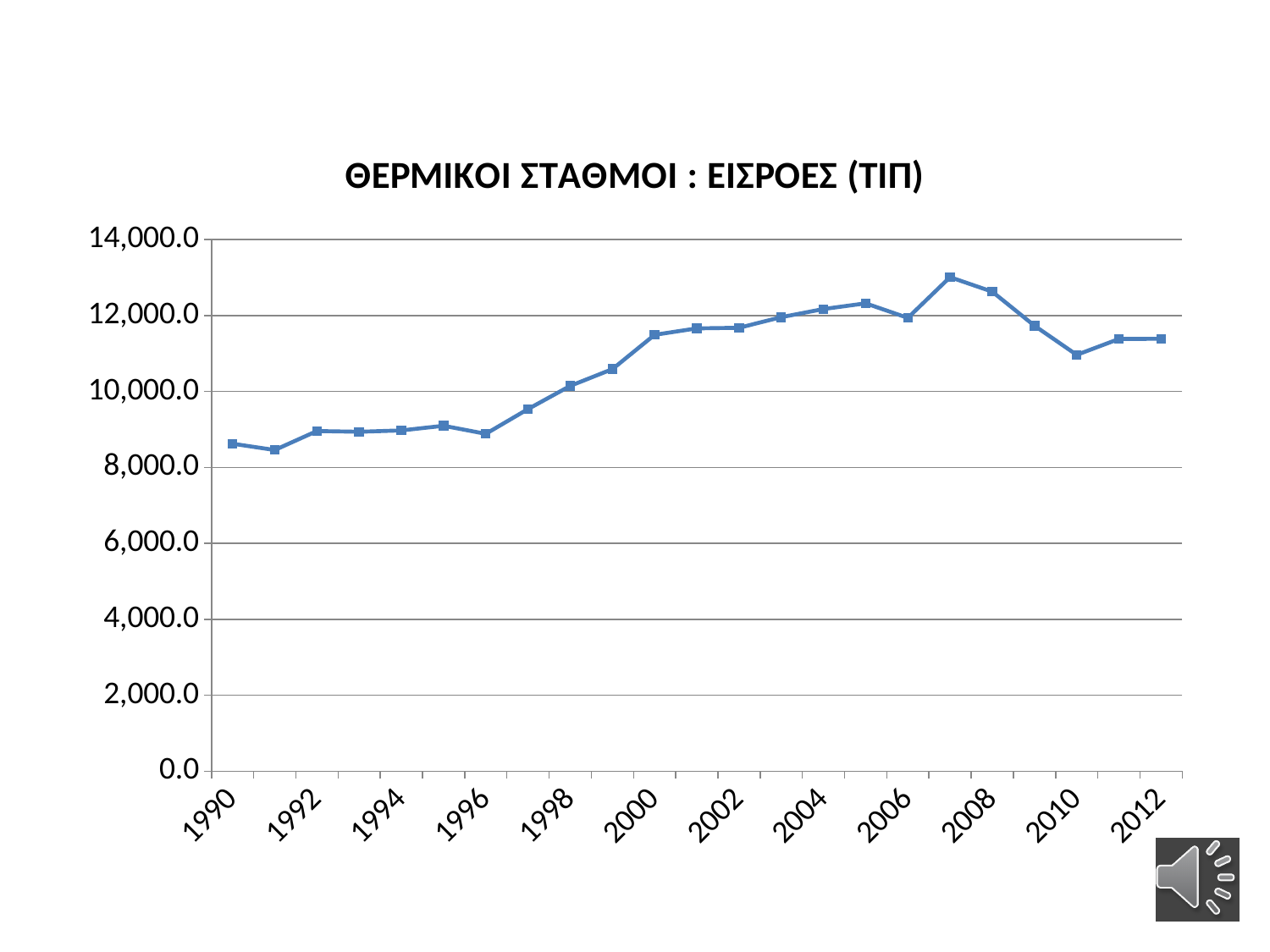
Do the values rise or fall from 1996 to 2000? rise Which year has the highest value? 2007 How many data points are plotted on the line? 23 Is the value for 2010 greater or less than 12,000.0? less Which is larger, the value for 2007 or the value for 1990? 2007 Is the value for 1999 greater or less than 10,000.0? greater What is the title of the chart? ΘΕΡΜΙΚΟΙ ΣΤΑΘΜΟΙ : ΕΙΣΡΟΕΣ (ΤΙΠ) Which is larger, the value for 2008 or the value for 2010? 2008 Do the values rise or fall from 2007 to 2010? fall What kind of chart is shown on the slide? line chart Is the value for 2007 greater or less than 12,000.0? greater